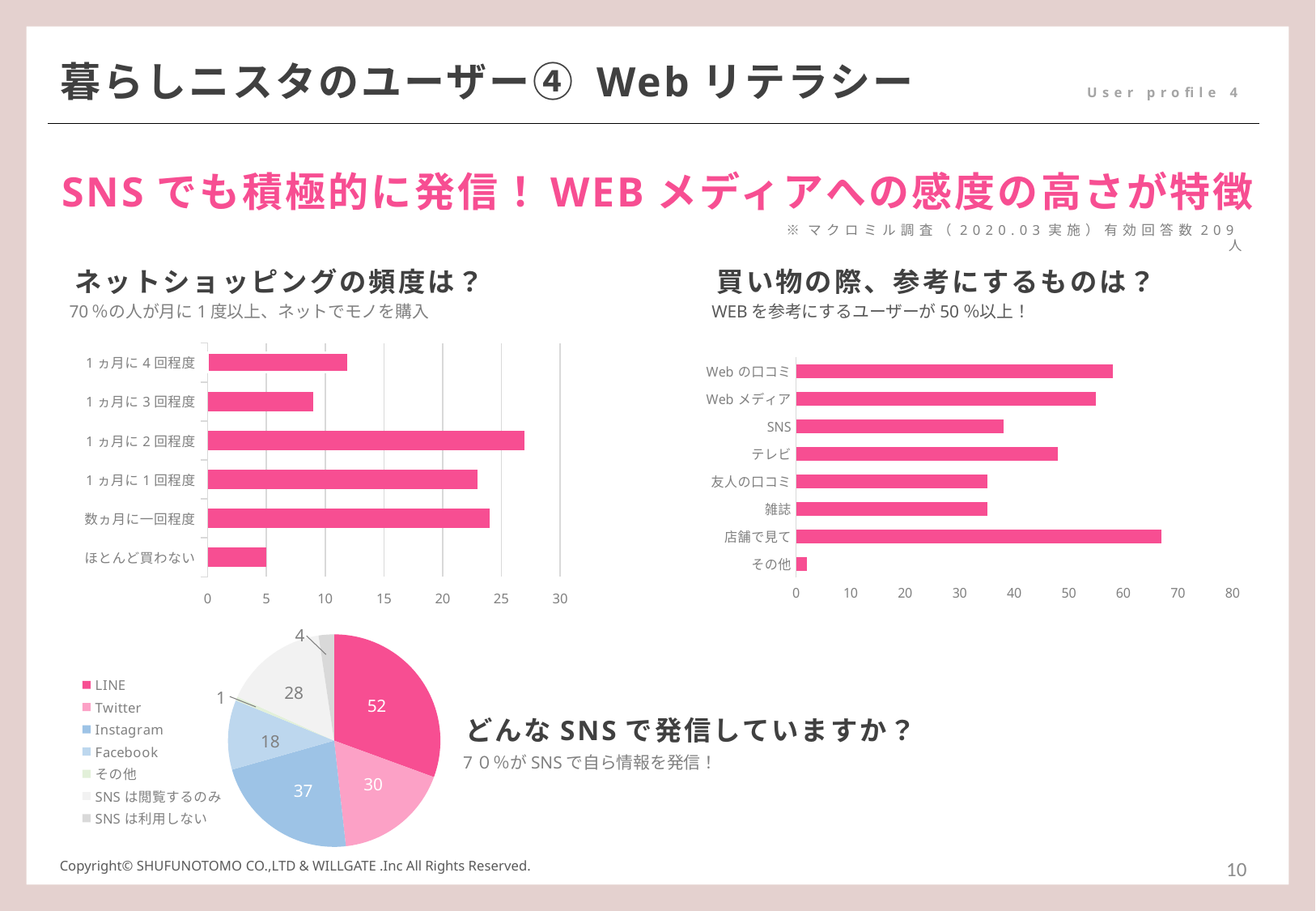
In the pie chart at the bottom left, what is the difference between the LINE value and the Twitter value? 22 In the chart titled 「買い物の際、参考にするものは？」, which category has the highest value? 店舗で見て In the chart titled 「ネットショッピングの頻度は？」, which category has the longest bar? 1ヵ月に2回程度 In the chart titled 「買い物の際、参考にするものは？」, how many categories are shown? 8 In the chart titled 「買い物の際、参考にするものは？」, which is larger, テレビ or SNS? テレビ In the chart titled 「買い物の際、参考にするものは？」, is the value for Web の口コミ greater or less than 50? greater In the pie chart at the bottom left, how many entries does the legend list? 7 In the chart titled 「ネットショッピングの頻度は？」, how many categories are shown? 6 In the chart titled 「買い物の際、参考にするものは？」, which category has the lowest value? その他 In the chart titled 「ネットショッピングの頻度は？」, is the value for 1ヵ月に2回程度 greater or less than 25? greater In the pie chart at the bottom left, what is the value for LINE? 52 In the chart titled 「ネットショッピングの頻度は？」, which category has the shortest bar? ほとんど買わない